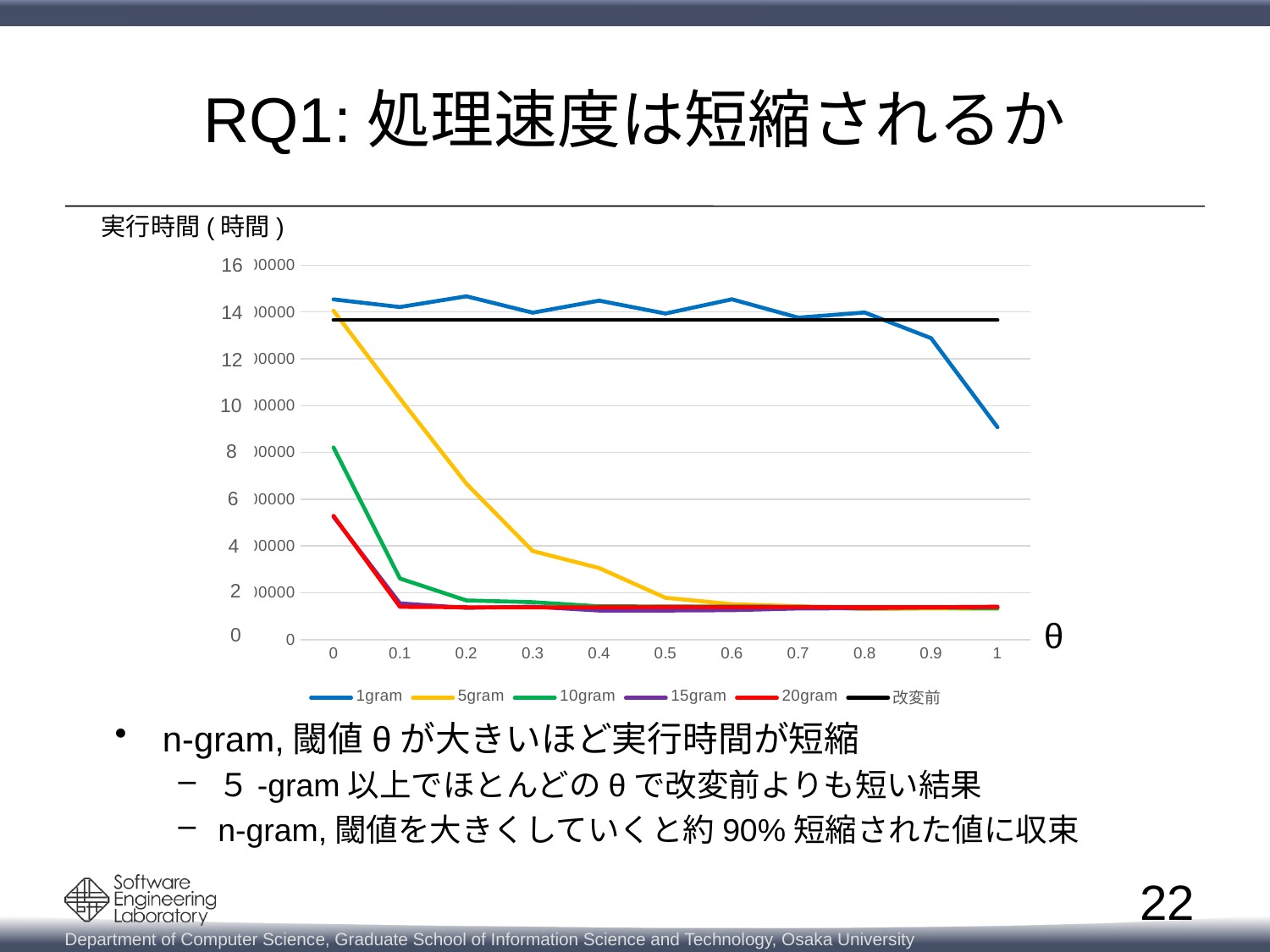
What is the label of the y axis? 実行時間 ( 時間 ) What kind of chart is shown on the slide? line chart Which series has the highest value at θ = 0? 1gram Is the value for 1gram at θ = 0 greater or less than 14? greater Is the value for 20gram at θ = 0 greater or less than 6? less At θ = 0.3, which is larger, the value for 5gram or the value for 10gram? 5gram Is the value for 1gram at θ = 1 greater or less than 10? less How many θ values are plotted along the x axis? 11 Does the 5gram series rise or fall as θ increases from 0 to 0.5? fall How many series does the legend list? 6